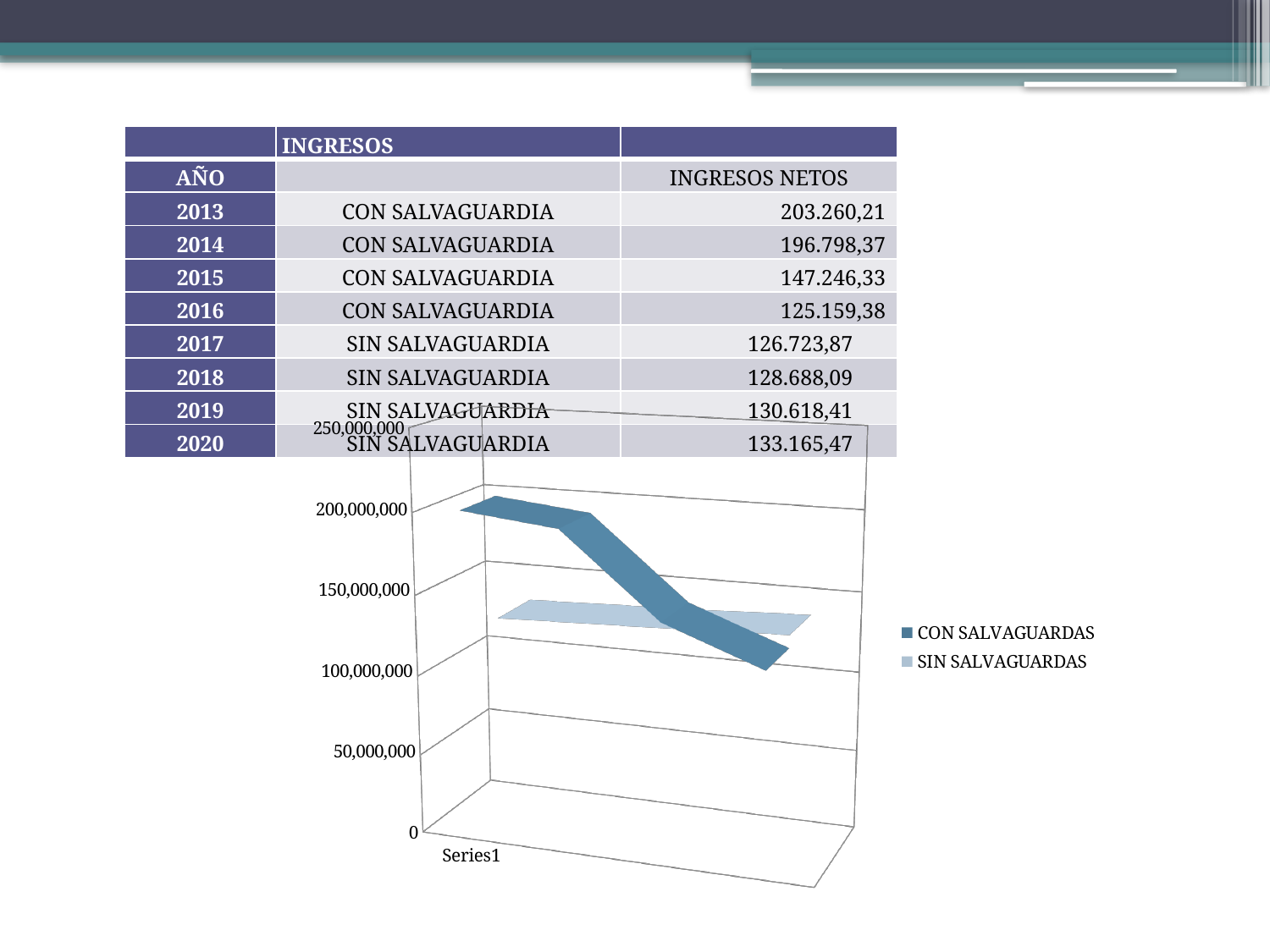
What label appears on the chart's horizontal axis? Series1 What are the two series named in the chart's legend? CON SALVAGUARDAS and SIN SALVAGUARDAS Is the starting value of the CON SALVAGUARDAS line greater or less than 150,000,000? greater Is the SIN SALVAGUARDAS line greater or less than 100,000,000? greater Which series reaches the highest value on the chart? CON SALVAGUARDAS What kind of chart is shown on the slide? line chart Is the SIN SALVAGUARDAS line greater or less than 150,000,000? less Does the CON SALVAGUARDAS line rise or fall from left to right? fall How many series does the chart's legend list? 2 At the left end of the chart, which series has the higher value, CON SALVAGUARDAS or SIN SALVAGUARDAS? CON SALVAGUARDAS